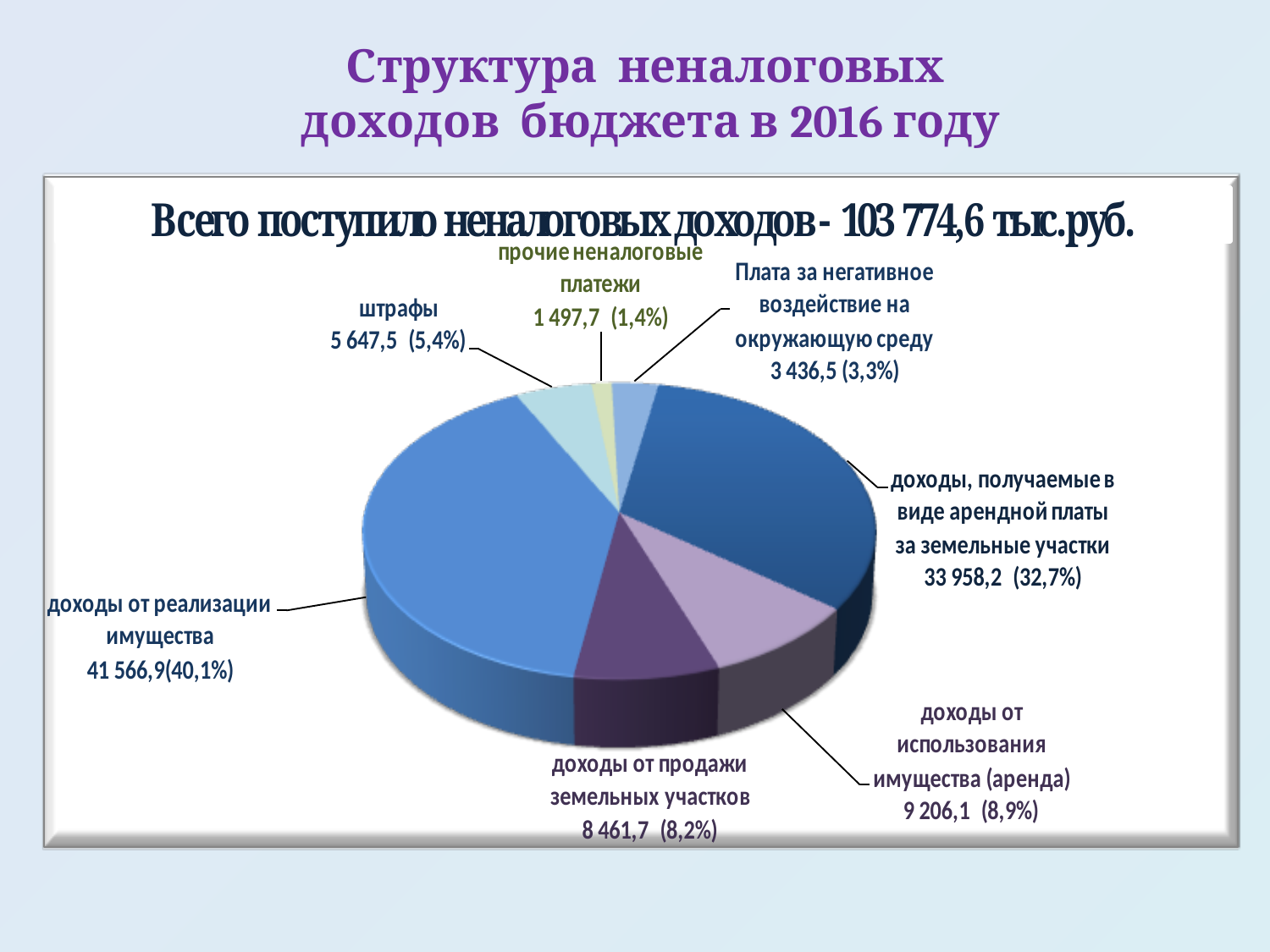
What share of the pie is «доходы, получаемые в виде арендной платы за земельные участки»? 32,7% What is the value for «доходы от реализации имущества»? 41 566,9 What share of the pie is «доходы от продажи земельных участков»? 8,2% Which category has the smallest slice of the pie? прочие неналоговые платежи What is the value for «Плата за негативное воздействие на окружающую среду»? 3 436,5 What is the value for «штрафы»? 5 647,5 What is the difference between «доходы от реализации имущества» and «доходы, получаемые в виде арендной платы за земельные участки»? 7 608,7 How many slices does the pie chart have? 7 What total amount of non-tax revenue is stated in the chart title? 103 774,6 тыс.руб. Which category has the largest slice of the pie? доходы от реализации имущества What kind of chart is shown on the slide? pie chart Which is larger: «доходы от использования имущества (аренда)» or «доходы от продажи земельных участков»? доходы от использования имущества (аренда)